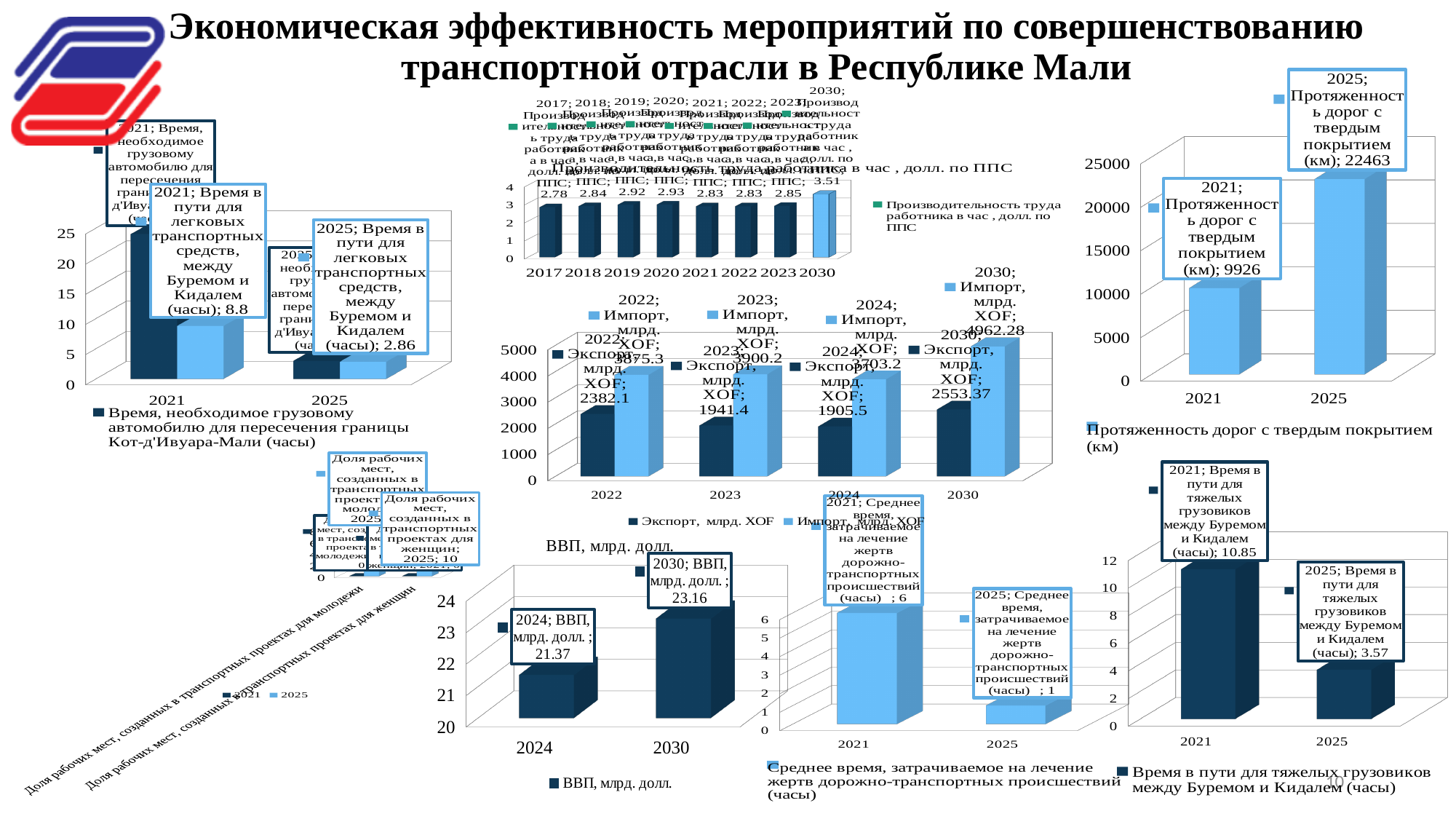
In the export/import chart (Экспорт, Импорт, млрд. XOF), what is the value of Экспорт for 2023? 1941.4 In the chart 'ВВП, млрд. долл.', what is the difference between the 2030 and 2024 values? 1.79 In the export/import chart (Экспорт, Импорт, млрд. XOF), what is the value of Импорт for 2030? 4962.28 In the chart titled 'Производительность труда работника в час, долл. по ППС', how many years are shown on the x axis? 8 In the export/import chart (Экспорт, Импорт, млрд. XOF), what is the difference between Импорт and Экспорт in 2024? 1797.7 In the chart 'Среднее время, затрачиваемое на лечение жертв дорожно-транспортных происшествий (часы)', what is the value for 2021? 6 In the chart titled 'Производительность труда работника в час, долл. по ППС', what is the value for 2030? 3.51 In the chart 'Протяженность дорог с твердым покрытием (км)', what is the value for 2025? 22463 In the export/import chart (Экспорт, Импорт, млрд. XOF), how many series does the legend list? 2 In the chart 'Протяженность дорог с твердым покрытием (км)', is the value for 2021 greater or less than 10000? less In the chart titled 'Производительность труда работника в час, долл. по ППС', which year has the lowest value? 2017 In the chart 'Время в пути для тяжелых грузовиков между Буремом и Кидалем (часы)', do the values rise or fall from 2021 to 2025? fall